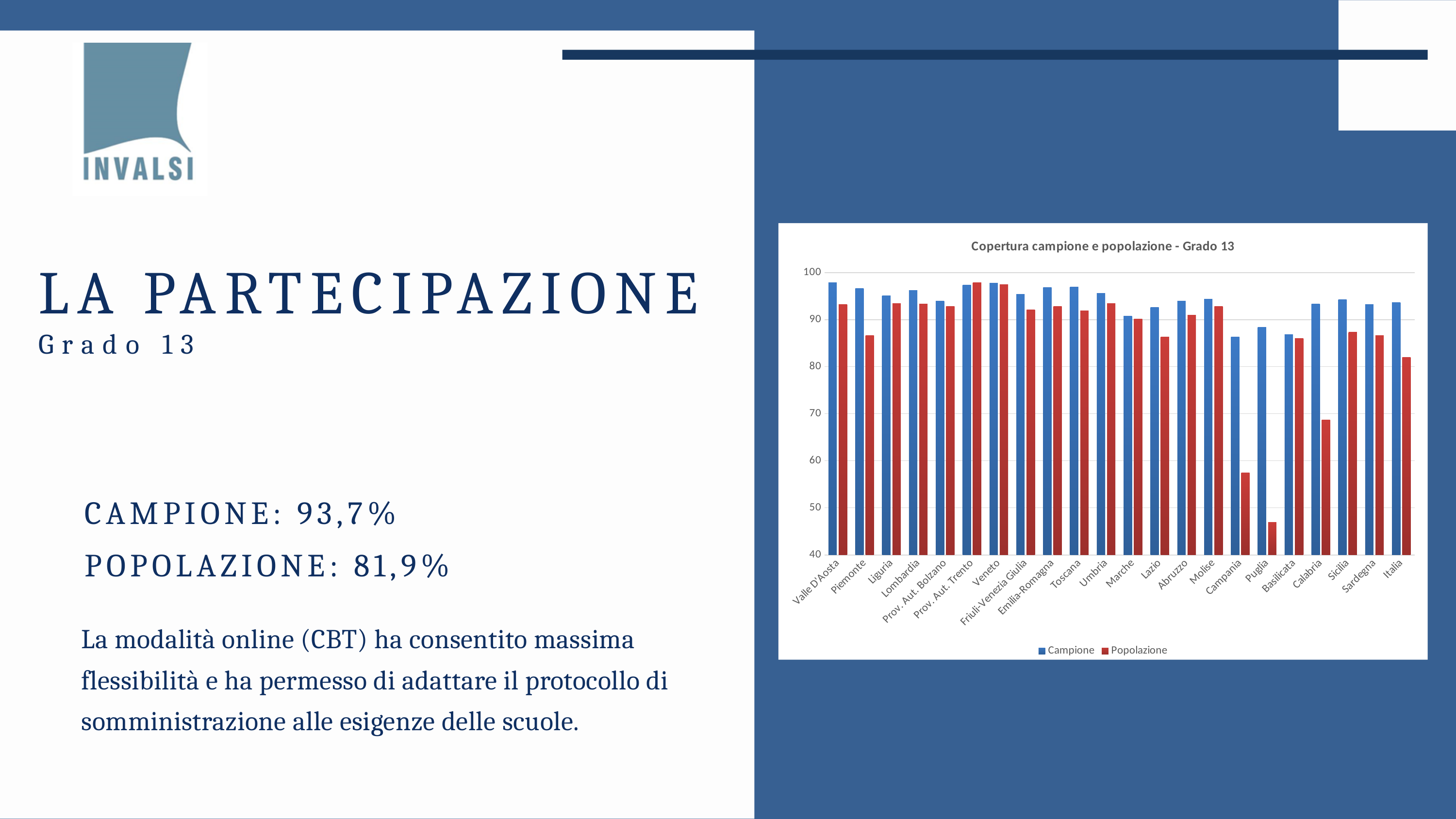
Is the Popolazione value for Campania greater or less than 60? less What kind of chart is shown on the slide? bar chart What is the title of the chart? Copertura campione e popolazione - Grado 13 Is the Popolazione value for Puglia greater or less than 50? less Which category has the lowest Popolazione value? Puglia For Campania, which is larger: the Campione value or the Popolazione value? Campione How many categories are shown on the x axis of the chart? 22 For Italia, which is larger: the Campione value or the Popolazione value? Campione How many series does the chart legend list? 2 Which series is shown in red in the chart? Popolazione Is the Popolazione value for Calabria greater or less than 70? less